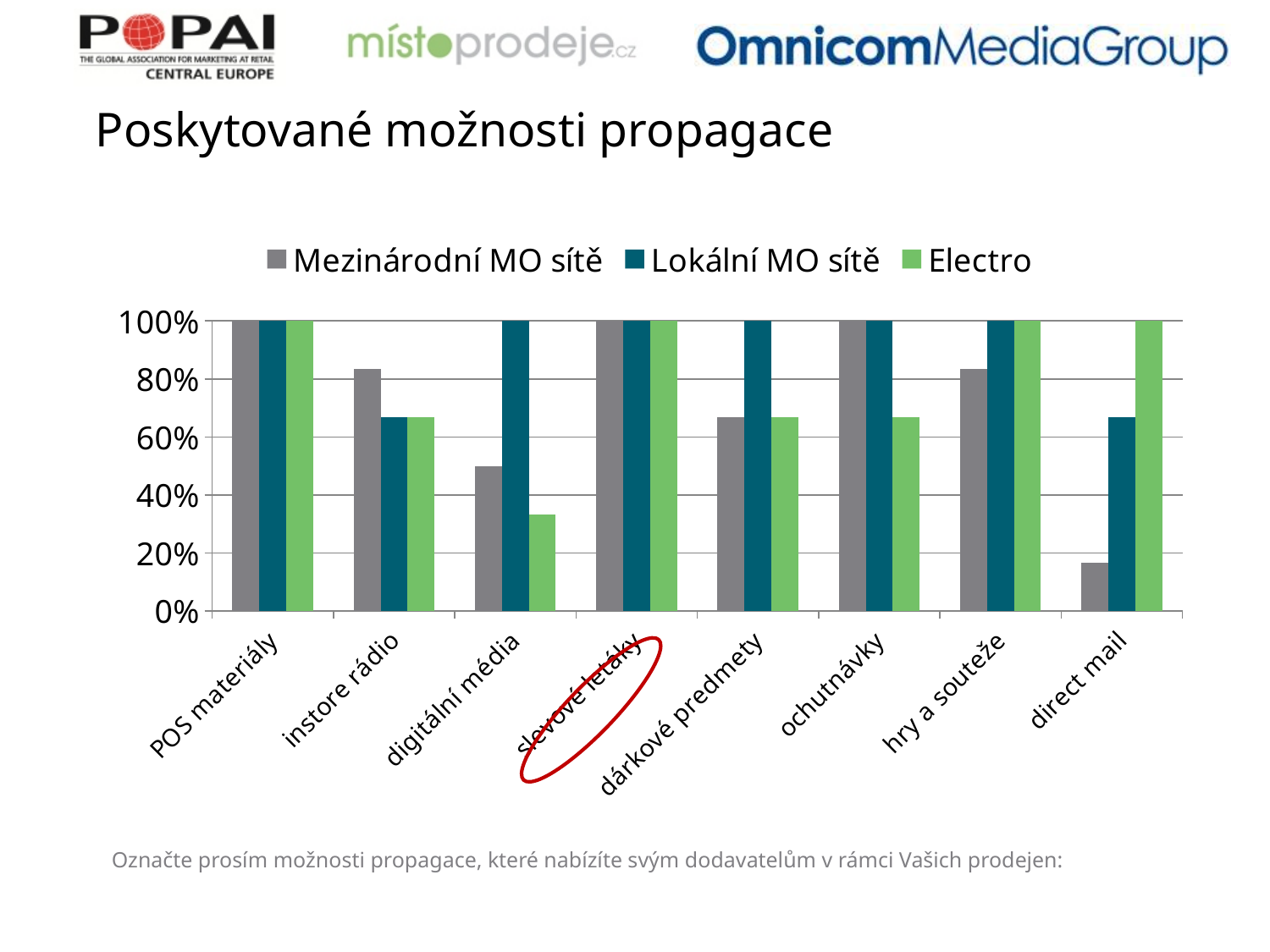
What is the value for Lokální MO sítě in the digitální média category? 100% In the direct mail category, which is larger: Mezinárodní MO sítě or Electro? Electro How many categories are shown on the x axis? 8 Is the value for Mezinárodní MO sítě in the digitální média category greater or less than 40%? greater What is the value for Electro in the direct mail category? 100% Is the value for Mezinárodní MO sítě in the direct mail category greater or less than 20%? less What kind of chart is shown on the slide? bar chart Is the value for Electro in the digitální média category greater or less than 40%? less How many series does the legend list? 3 Which category label on the x axis is circled in red? slevové letáky Which category has the lowest value for Mezinárodní MO sítě? direct mail In the digitální média category, which is larger: Lokální MO sítě or Electro? Lokální MO sítě